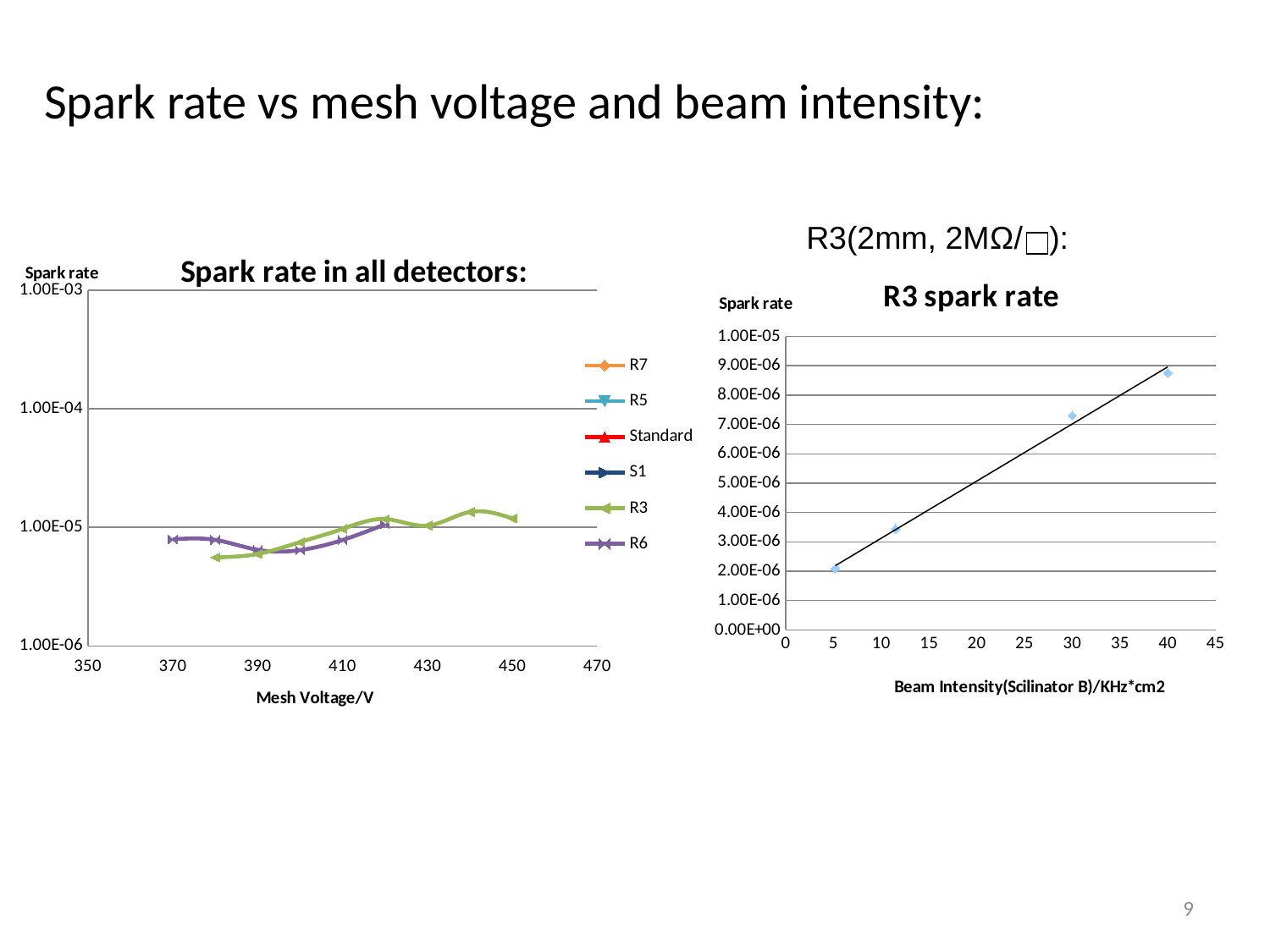
In the 'R3 spark rate' chart, is the spark rate at a beam intensity of 40 greater or less than 8.00E-06? greater How many data points are plotted in the 'R3 spark rate' chart? 4 How many series does the legend of the 'Spark rate in all detectors:' chart list? 6 What is the x-axis title of the 'Spark rate in all detectors:' chart? Mesh Voltage/V In the 'R3 spark rate' chart, is the spark rate at a beam intensity of 5 greater or less than 3.00E-06? less What kind of chart is the 'Spark rate in all detectors:' chart? line chart In the 'Spark rate in all detectors:' chart, is the R6 value at 370 V greater or less than 1.00E-05? less What is the x-axis title of the 'R3 spark rate' chart? Beam Intensity(Scilinator B)/KHz*cm2 In the 'R3 spark rate' chart, do the spark rate values rise or fall as beam intensity increases? rise In the 'R3 spark rate' chart, at which beam intensity is the spark rate highest? 40